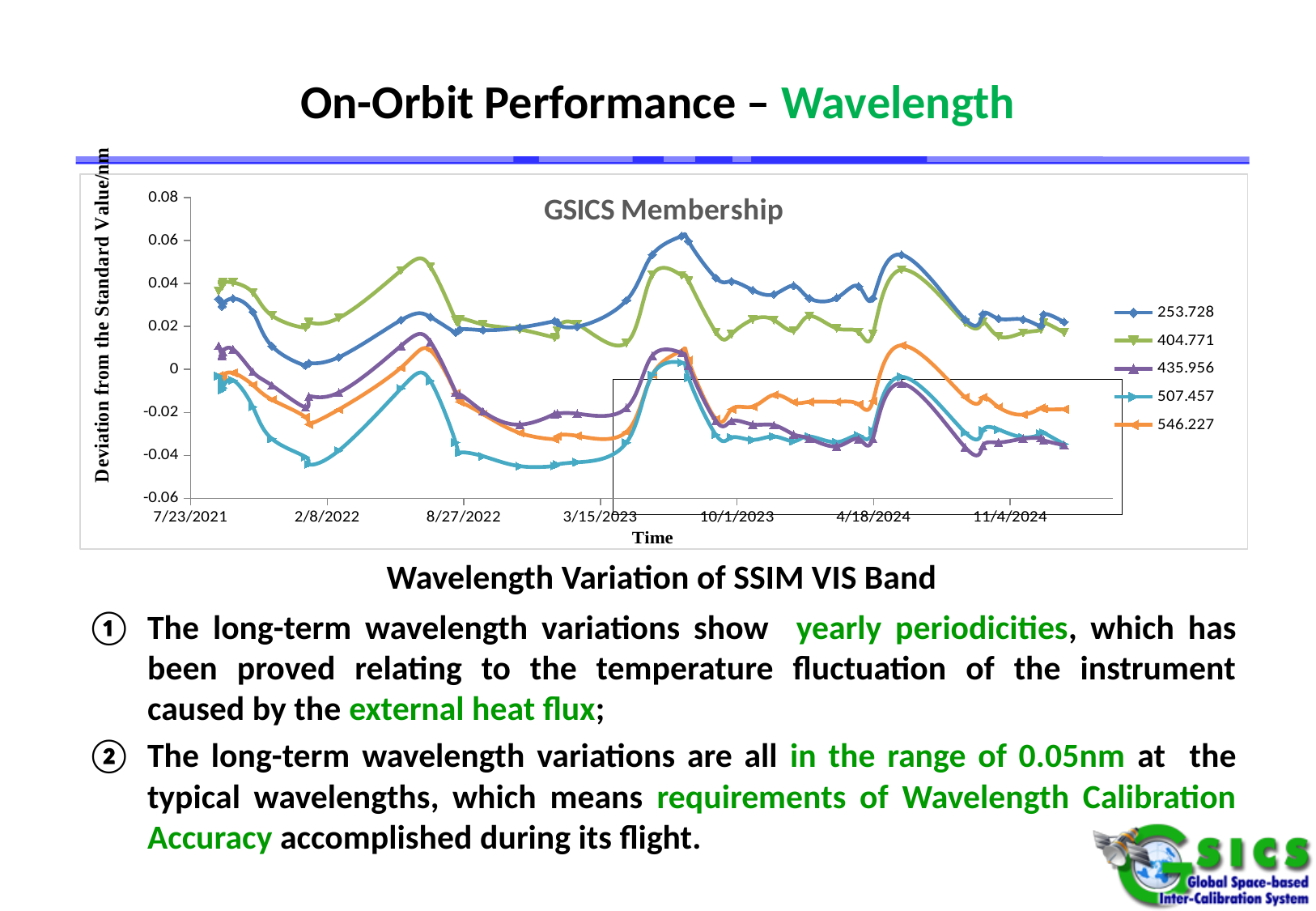
What is the title of the vertical axis of the chart? Deviation from the Standard Value/nm Which series reaches the highest value on the chart? 253.728 Is the value of the 404.771 series at 2/8/2022 greater or less than 0? greater Does the 253.728 series rise or fall between 7/23/2021 and 2/8/2022? fall How many date labels are shown on the x axis of the chart? 7 What are the series names listed in the chart legend? 253.728, 404.771, 435.956, 507.457, 546.227 How many series does the chart legend list? 5 Is the lowest value of the 507.457 series greater or less than -0.02? less Is the value of the 546.227 series at 11/4/2024 greater or less than 0? less Which series reaches the lowest value on the chart? 507.457 What kind of chart is shown on the slide? line chart